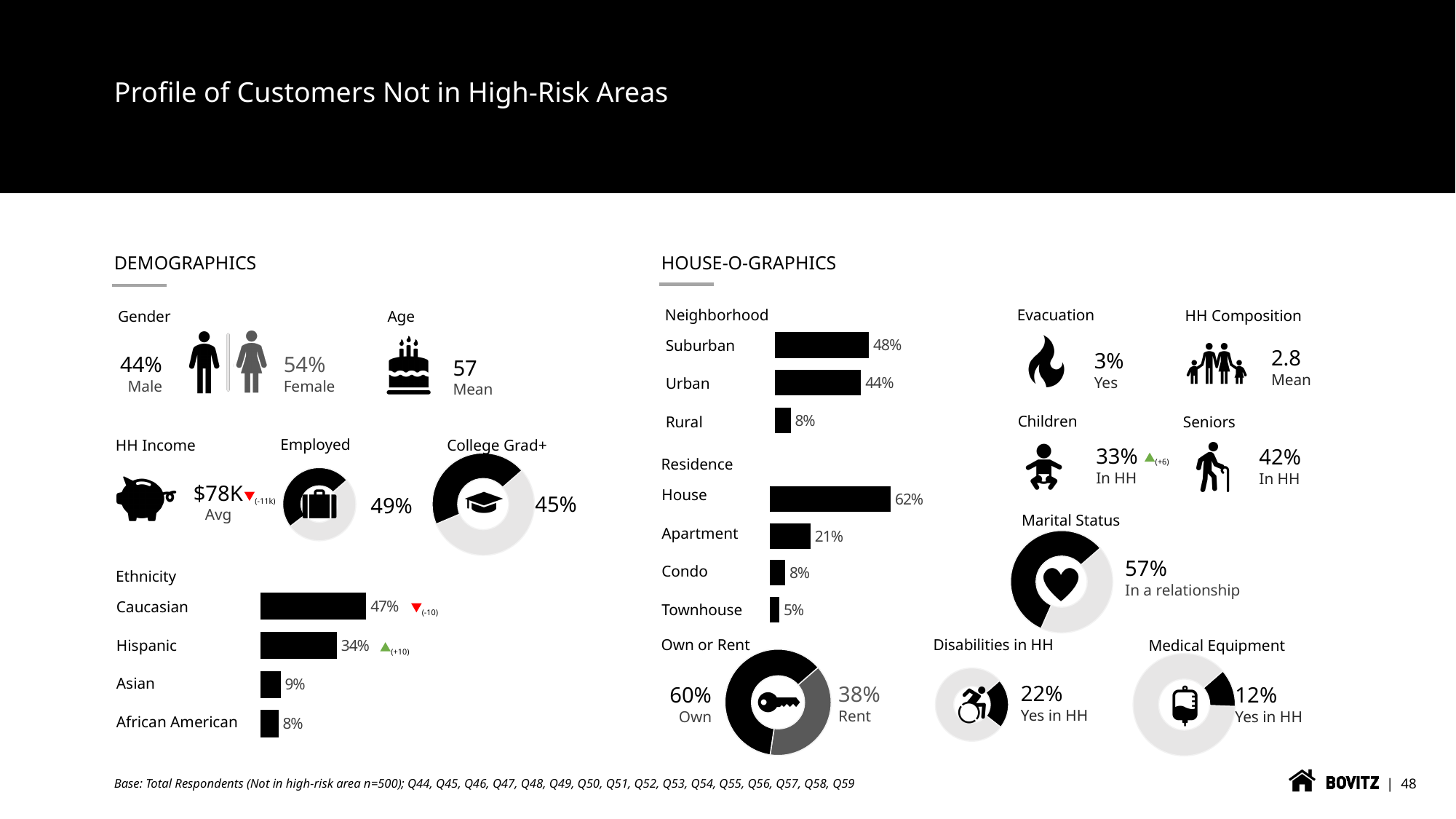
In the Ethnicity bar chart, what percentage is shown for Caucasian? 47% In the Residence bar chart, which is larger, Apartment or Condo? Apartment In the Marital Status donut chart, what percentage is shown for In a relationship? 57% What kind of chart is used for Neighborhood? Bar chart In the Neighborhood bar chart, what is the difference between Suburban and Rural? 40% In the Own or Rent donut chart, what percentage is shown for Rent? 38% In the Ethnicity bar chart, how many categories are shown? 4 In the Residence bar chart, how many categories are shown? 4 In the Residence bar chart, which category has the highest value? House In the Neighborhood bar chart, what percentage is shown for Urban? 44% In the Ethnicity bar chart, which category has the lowest value? African American In the Residence bar chart, what percentage is shown for Townhouse? 5%